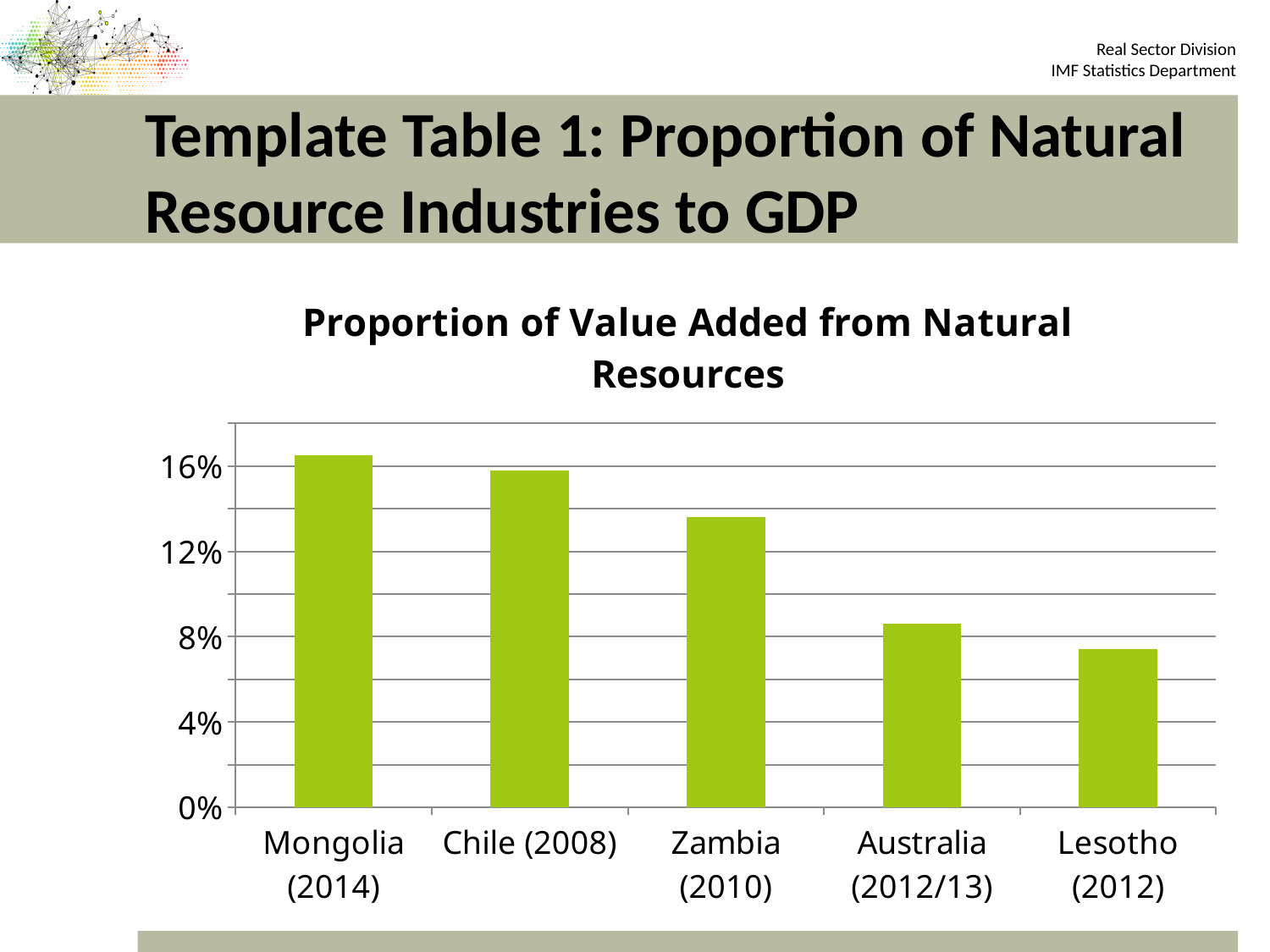
Do the values rise or fall from left to right across the chart? fall Which country has the highest proportion of value added from natural resources? Mongolia (2014) Is the value for Mongolia (2014) greater or less than 16%? greater Which is larger, the value for Zambia (2010) or the value for Australia (2012/13)? Zambia (2010) Is the value for Zambia (2010) greater or less than 12%? greater What is the title of the chart? Proportion of Value Added from Natural Resources Is the value for Lesotho (2012) greater or less than 8%? less What kind of chart is shown on the slide? bar chart How many countries are shown on the chart? 5 Which country has the lowest proportion of value added from natural resources? Lesotho (2012)